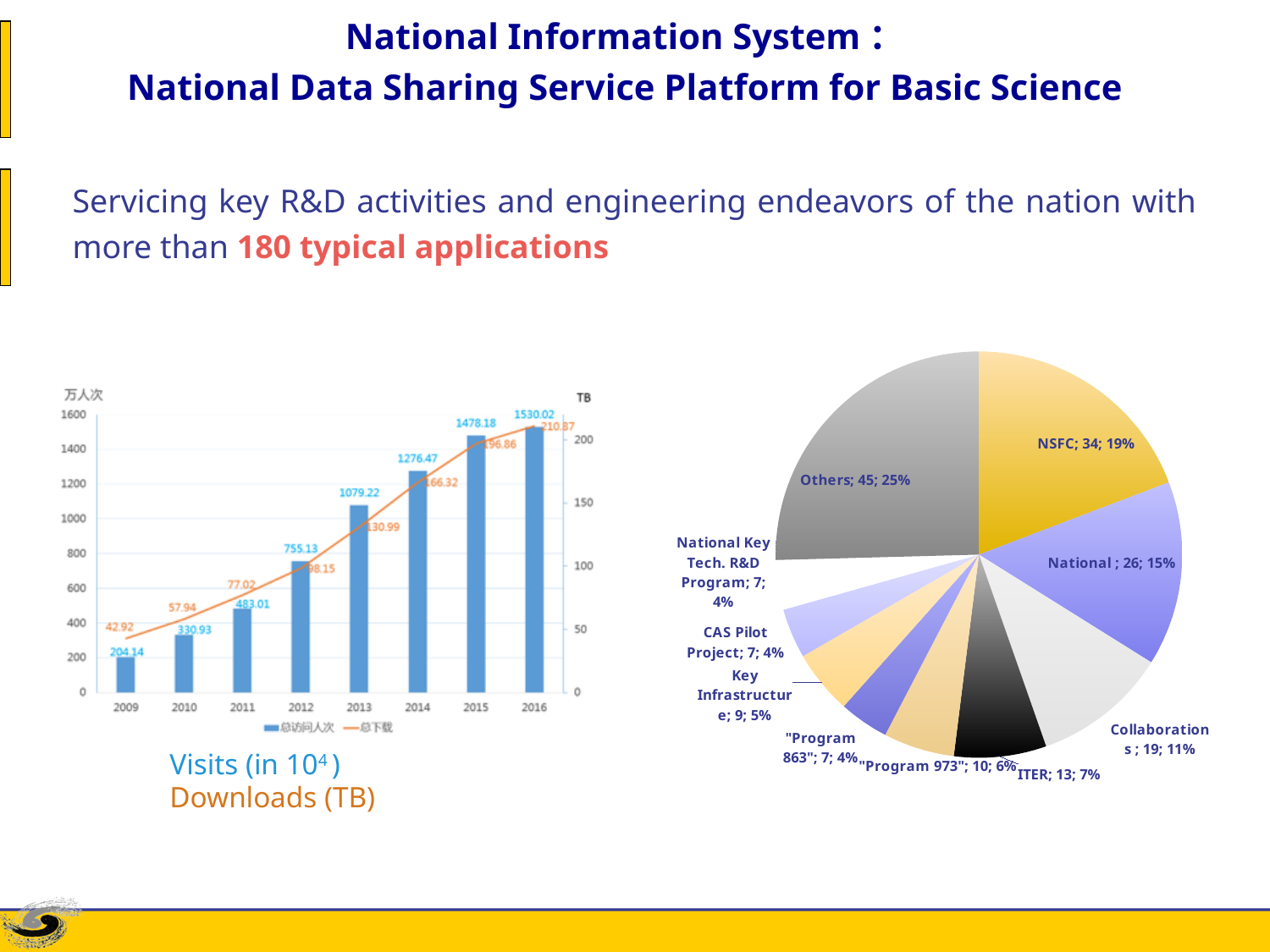
In the left chart (Visits and Downloads), what is the downloads value (TB) for 2011? 77.02 In the left chart (Visits and Downloads), what is the number of visits (in 10^4) for 2009? 204.14 In the left chart (Visits and Downloads), what is the number of visits (in 10^4) for 2016? 1530.02 In the left chart (Visits and Downloads), which year has the highest number of visits? 2016 In the pie chart on the right, which is larger, National or Collaborations? National In the pie chart on the right, what share does NSFC have? 19% In the left chart (Visits and Downloads), do the visits rise or fall from 2009 to 2016? rise In the pie chart on the right, how many slices are there? 10 In the left chart (Visits and Downloads), what is the difference in visits between 2013 and 2012? 324.09 In the pie chart on the right, which category has the largest share? Others In the pie chart on the right, what is the count value for ITER? 13 In the left chart (Visits and Downloads), how many years are shown on the x axis? 8